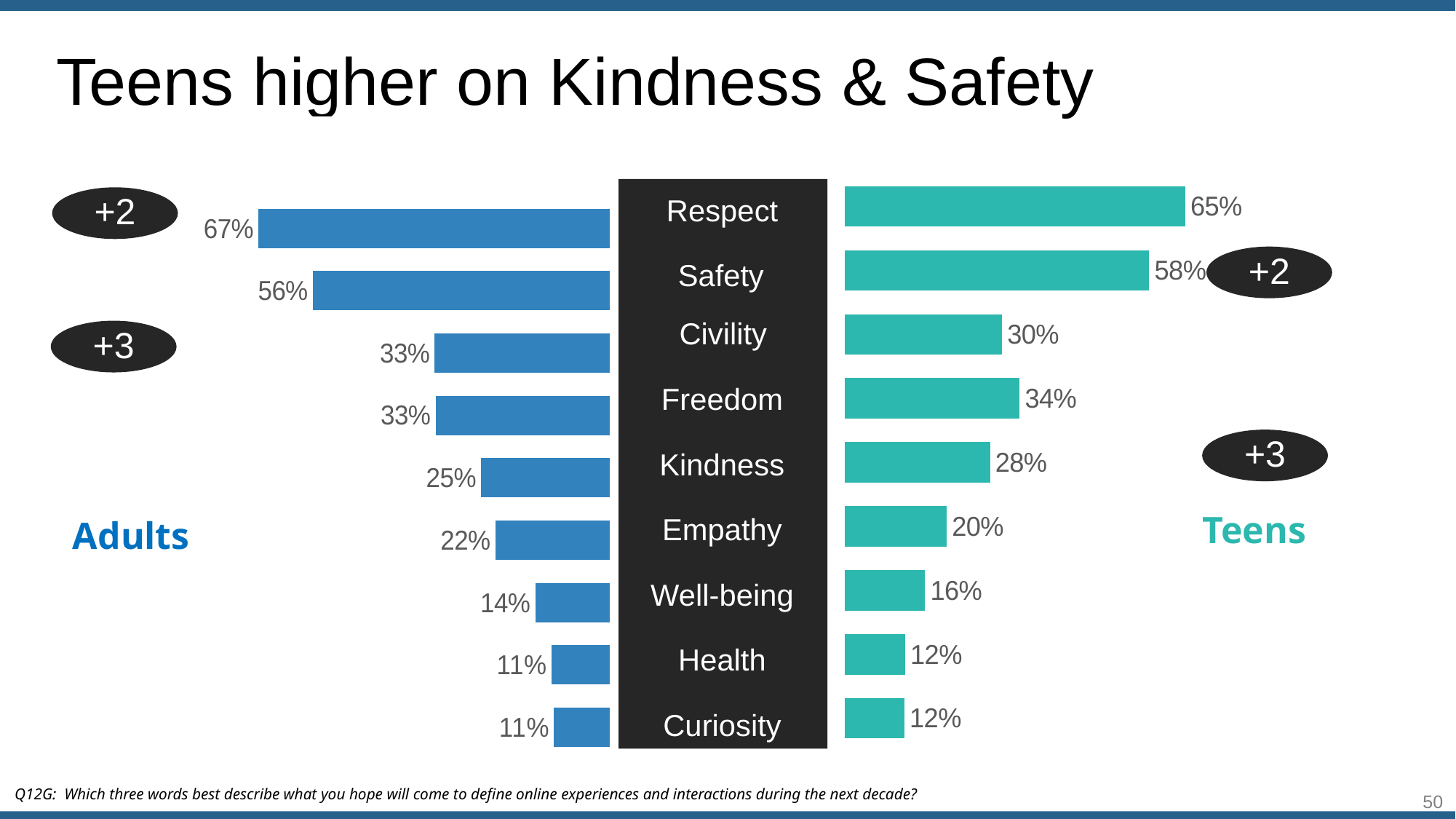
Which is larger, the Adults value for Safety or the Teens value for Safety? Teens (58%) Which category has the lowest value for Teens? Health and Curiosity (12%) What percentage of Adults chose Respect? 67% Which colour represents the Teens bars? Teal Which category has the highest value for Teens? Respect What percentage of Teens chose Safety? 58% How many categories are shown in the chart? 9 What percentage of Teens chose Kindness? 28% What is the difference between the Teens and Adults values for Kindness? 3 percentage points What is the difference between the Adults and Teens values for Civility? 3 percentage points What type of chart is shown on the slide? Bar chart What percentage of Adults chose Empathy? 22%